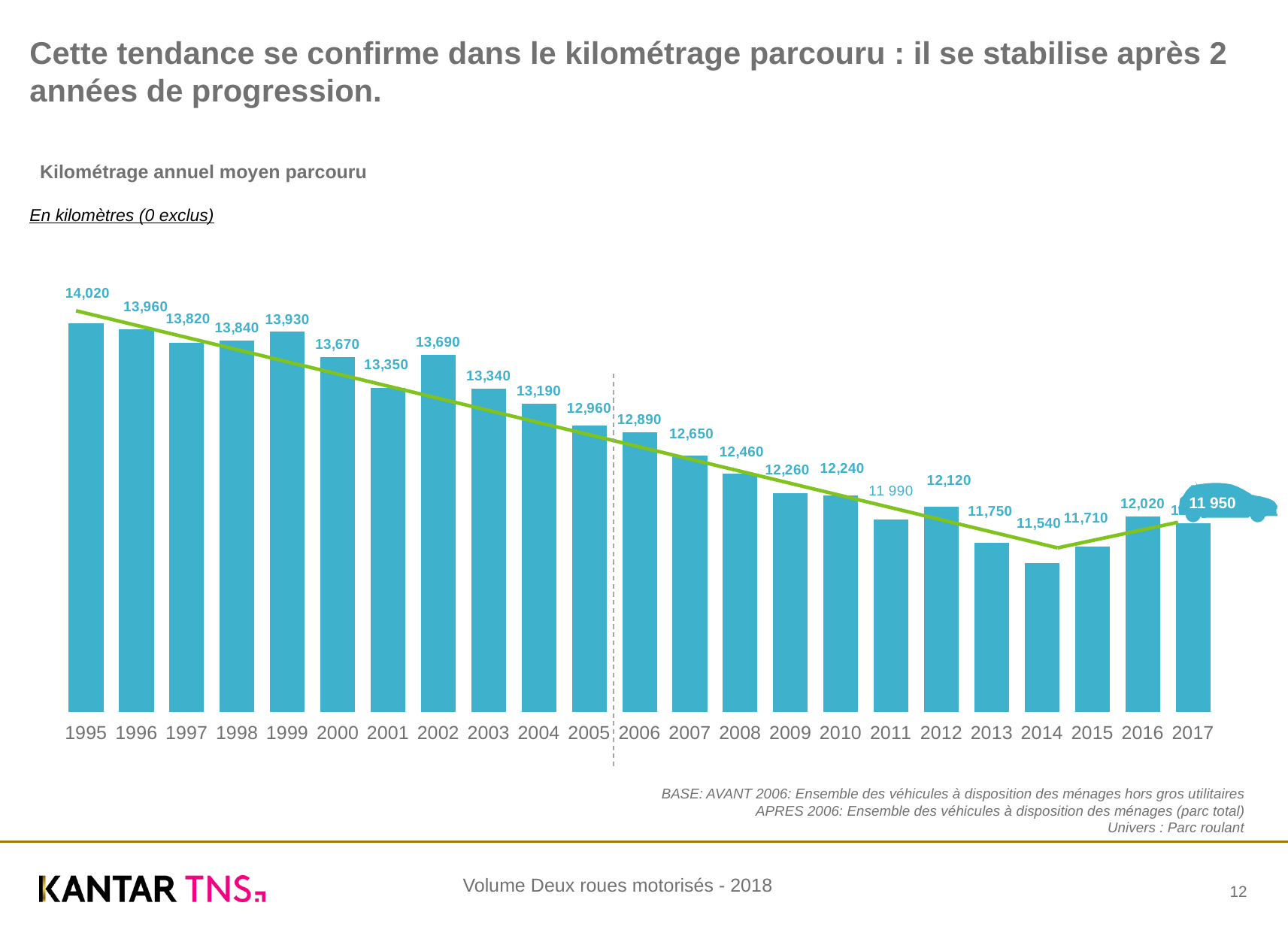
What is the difference between the values for 2016 and 2015? 310 Which is larger, the value for 2001 or the value for 2002? 2002 What is the value for 2002? 13,690 Which year has the highest value? 1995 Which year has the lowest value? 2014 How many years are shown on the x axis? 23 What is the value for 2011? 11 990 What kind of chart is this? bar chart Do the values generally rise or fall from 1995 to 2014? fall What is the difference between the values for 2013 and 2014? 210 What is the value for 1995? 14,020 What is the value for 2014? 11,540